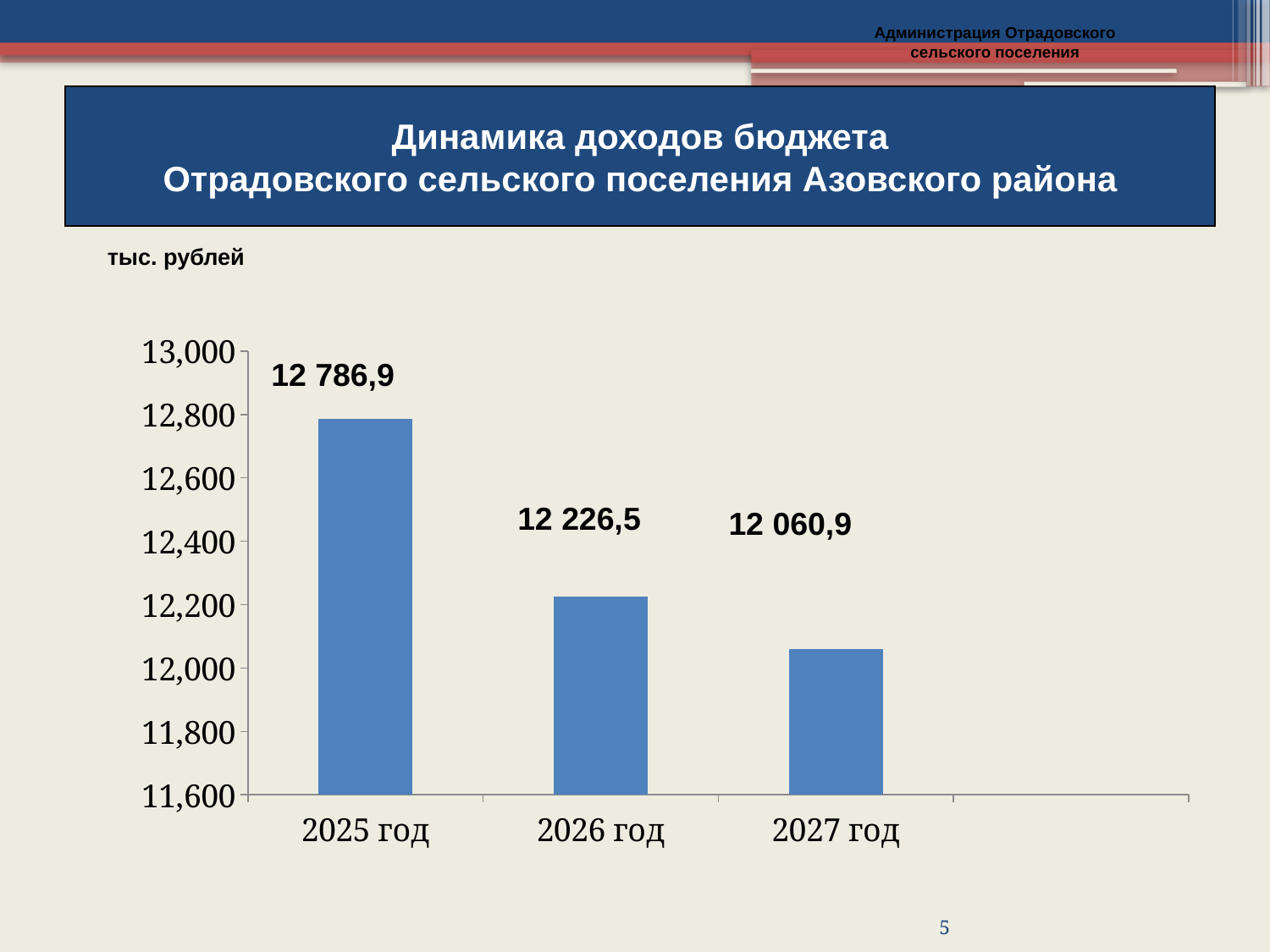
What kind of chart is shown on the slide? bar chart What is the budget revenue value shown for 2027 год? 12 060,9 What is the difference between the values for 2025 год and 2026 год? 560,4 Which year has the highest budget revenue? 2025 год Which year has the lowest budget revenue? 2027 год Which is larger, the value for 2026 год or the value for 2027 год? 2026 год What is the budget revenue value shown for 2025 год? 12 786,9 How many years are shown on the chart? 3 Do the values rise or fall from 2025 год to 2027 год? fall Is the value for 2027 год greater or less than 12,200? less What is the difference between the values for 2026 год and 2027 год? 165,6 What is the budget revenue value shown for 2026 год? 12 226,5